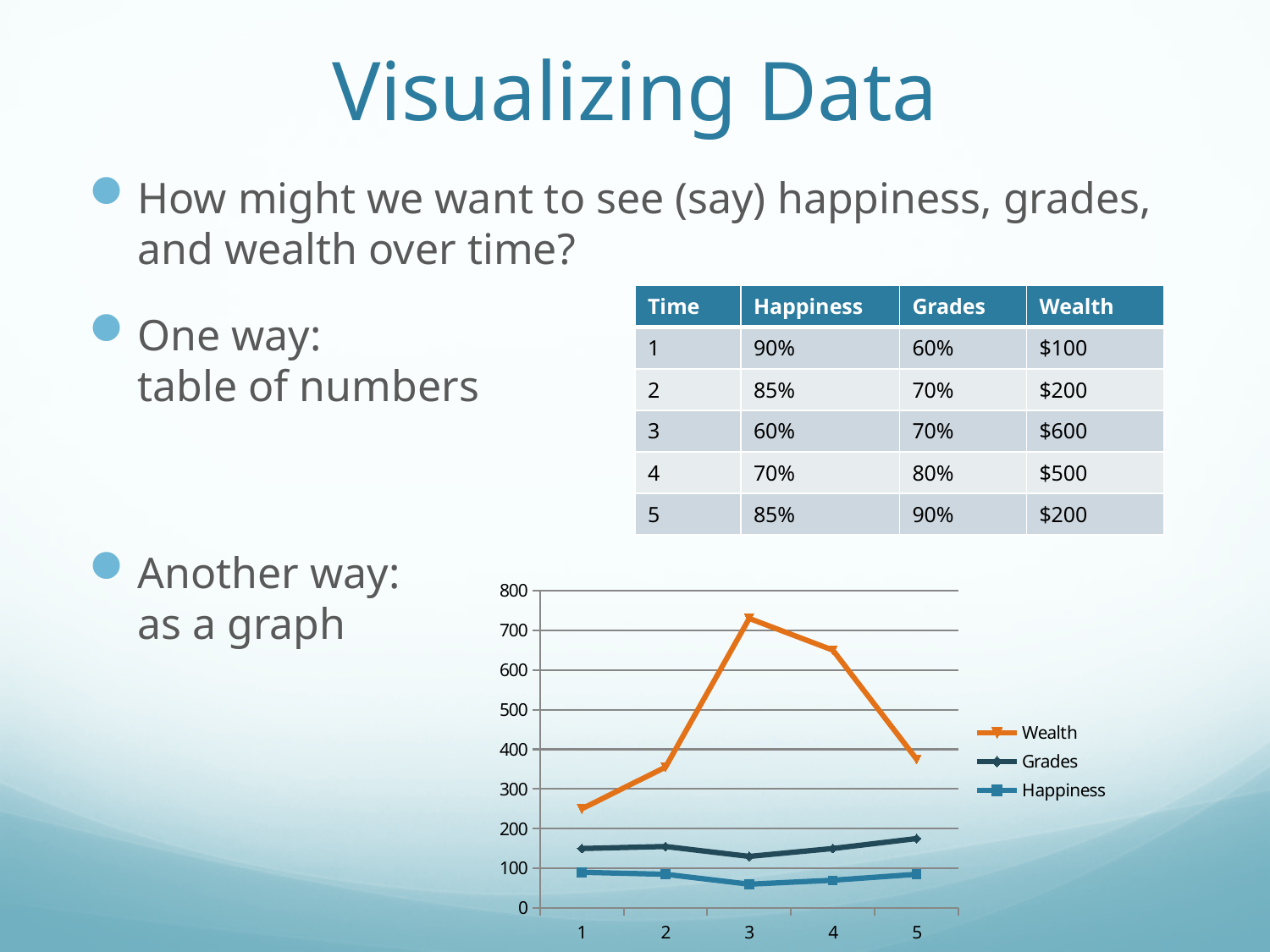
What kind of chart is shown on the slide? line chart How many series does the chart's legend list? 3 Which is larger: Wealth at time 3 or Wealth at time 4? Wealth at time 3 At time 5, which series has the larger value: Grades or Happiness? Grades Does the Wealth series rise or fall from time 3 to time 5? fall At which time point does the Wealth series reach its highest value? 3 How many time points are plotted along the x axis of the chart? 5 Is the value of Happiness at time 3 greater or less than 100? less Is the value of Wealth at time 1 greater or less than 300? less At which time point is the Wealth series at its lowest value? 1 What colour is the Wealth line in the chart? orange